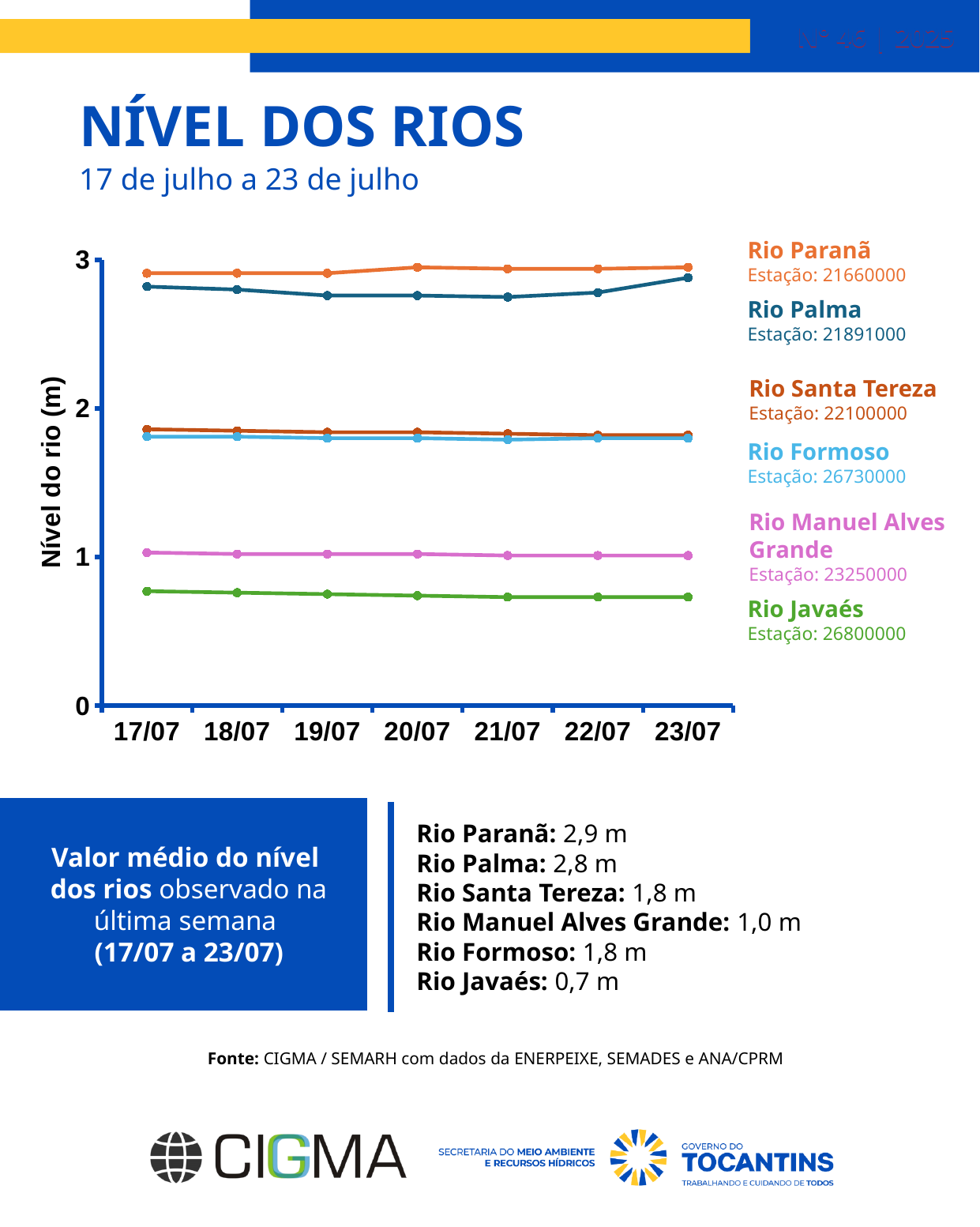
Is the level of Rio Palma on 21/07 greater or less than 2 m? greater Which river has the lowest level throughout the week shown in the chart? Rio Javaés Does the level of Rio Javaés rise or fall from 17/07 to 23/07? fall Is the level of Rio Javaés on 17/07 greater or less than 1 m? less Is the level of Rio Santa Tereza on 19/07 greater or less than 2 m? less Which river has a higher level on 23/07, Rio Paranã or Rio Palma? Rio Paranã How many dates are plotted along the x axis of the chart? 7 What kind of chart is shown on the slide? line chart How many rivers (series) does the chart legend list? 6 What station number is listed in the legend for Rio Paranã? 21660000 Which river has the highest level throughout the week shown in the chart? Rio Paranã Which river has a higher level on 20/07, Rio Manuel Alves Grande or Rio Javaés? Rio Manuel Alves Grande